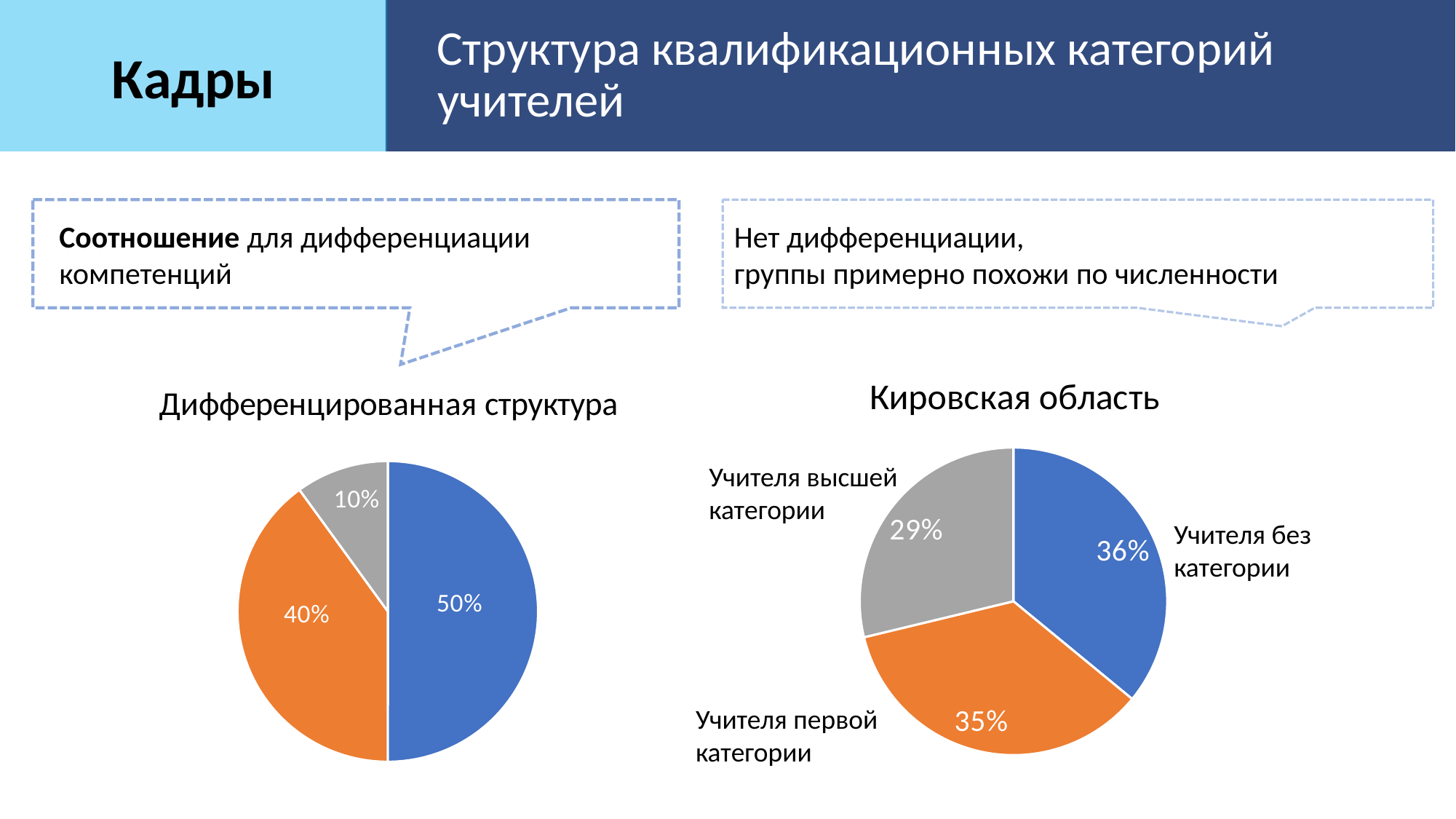
In the "Дифференцированная структура" chart, what is the value of the largest slice? 50% In the "Кировская область" chart, which category has the smallest share? Учителя высшей категории In the "Дифференцированная структура" chart, what is the value of the smallest slice? 10% In the "Кировская область" chart, what share do "Учителя без категории" have? 36% How many slices does the "Кировская область" pie chart have? 3 In the "Кировская область" chart, what is the difference in percentage points between "Учителя без категории" and "Учителя высшей категории"? 7 percentage points In the "Дифференцированная структура" chart, what is the difference between the blue slice and the grey slice? 40 percentage points In the "Кировская область" chart, what share do "Учителя высшей категории" have? 29% In the "Кировская область" chart, which category has the largest share? Учителя без категории In the "Кировская область" chart, what share do "Учителя первой категории" have? 35% In the "Дифференцированная структура" chart, what is the value of the orange slice? 40% What type of chart is used on the slide for "Кировская область"? Pie chart